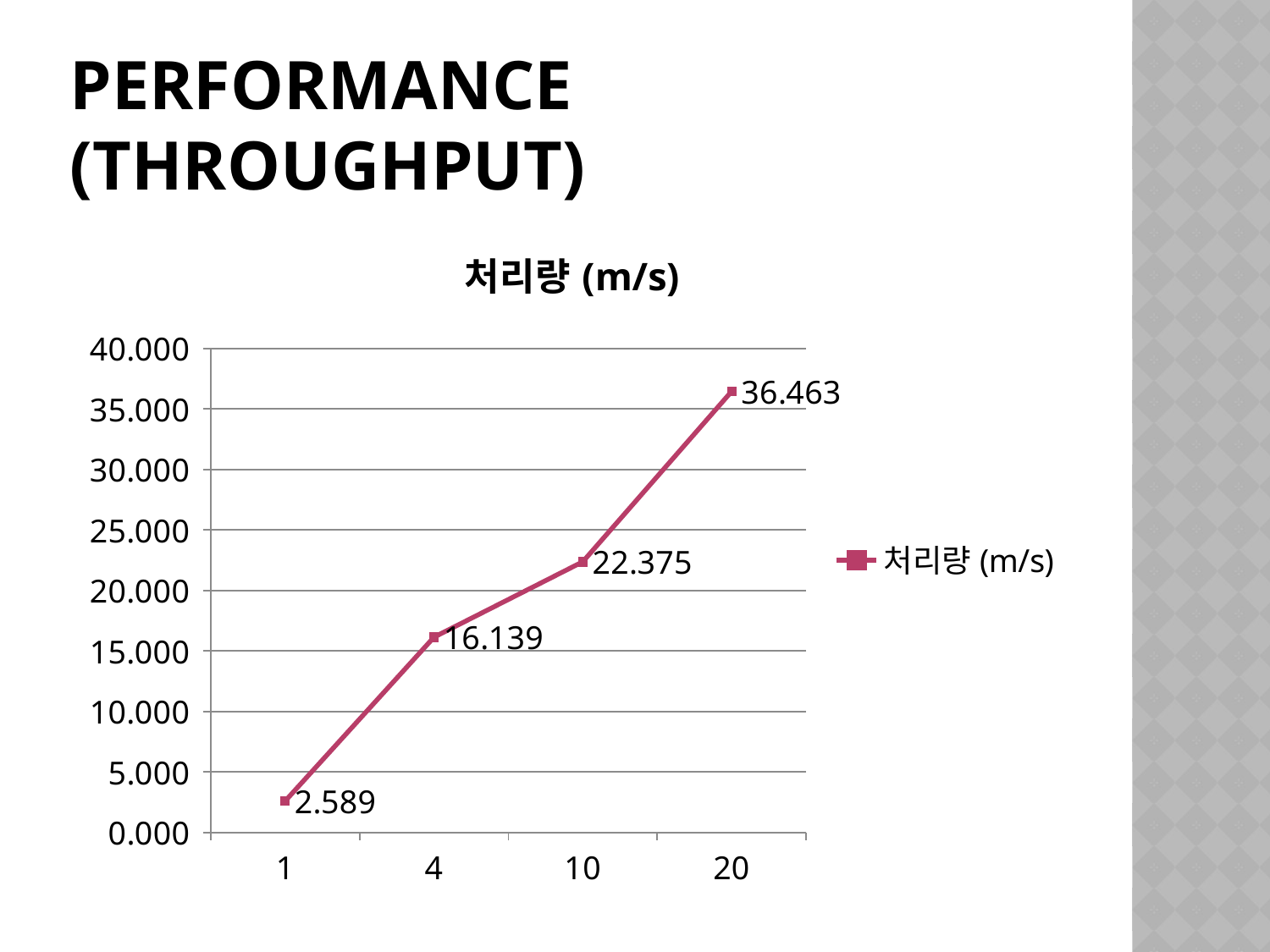
What is the value for category 4? 16.139 What is the value for category 10? 22.375 What is the difference between the values for category 20 and category 10? 14.088 What is the value for category 1? 2.589 Which category has the lowest value? 1 Which is larger, the value for category 4 or the value for category 10? 10 What kind of chart is shown on the slide? line chart Which category has the highest value? 20 How many data points are plotted on the chart? 4 What is the value for category 20? 36.463 How many series does the legend list? 1 Do the values rise or fall along the x axis? rise